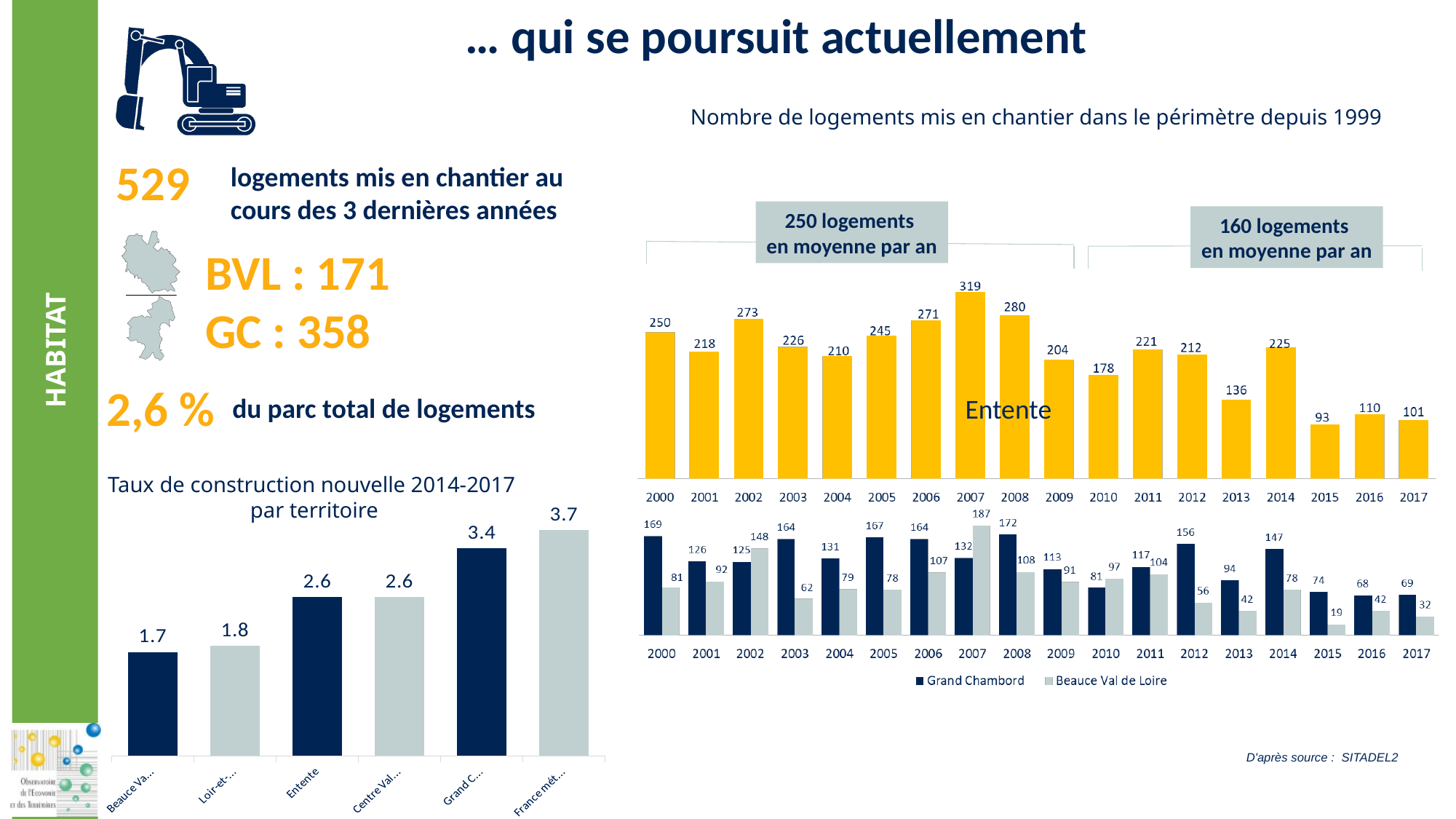
What kind of chart is 'Taux de construction nouvelle 2014-2017 par territoire'? Bar chart In the 'Entente' chart of housing starts, which year has the highest value? 2007 In the 'Entente' chart of housing starts, how many years are shown on the x axis? 18 In the chart 'Taux de construction nouvelle 2014-2017 par territoire', how many bars are shown? 6 In the bottom-right chart comparing Grand Chambord and Beauce Val de Loire, how many series does the legend list? 2 In the 'Entente' chart of housing starts, which year has the lowest value? 2015 In the bottom-right chart comparing Grand Chambord and Beauce Val de Loire, what is the lowest value for Beauce Val de Loire and in which year? 19 in 2015 In the bottom-right chart comparing Grand Chambord and Beauce Val de Loire, which series has the larger value in 2012? Grand Chambord In the 'Entente' chart of housing starts, what is the value for 2007? 319 In the 'Entente' chart of housing starts, what is the difference between the values for 2000 and 2017? 149 In the chart 'Taux de construction nouvelle 2014-2017 par territoire', what is the value for Entente? 2.6 In the bottom-right chart comparing Grand Chambord and Beauce Val de Loire, what is the value for Beauce Val de Loire in 2007? 187